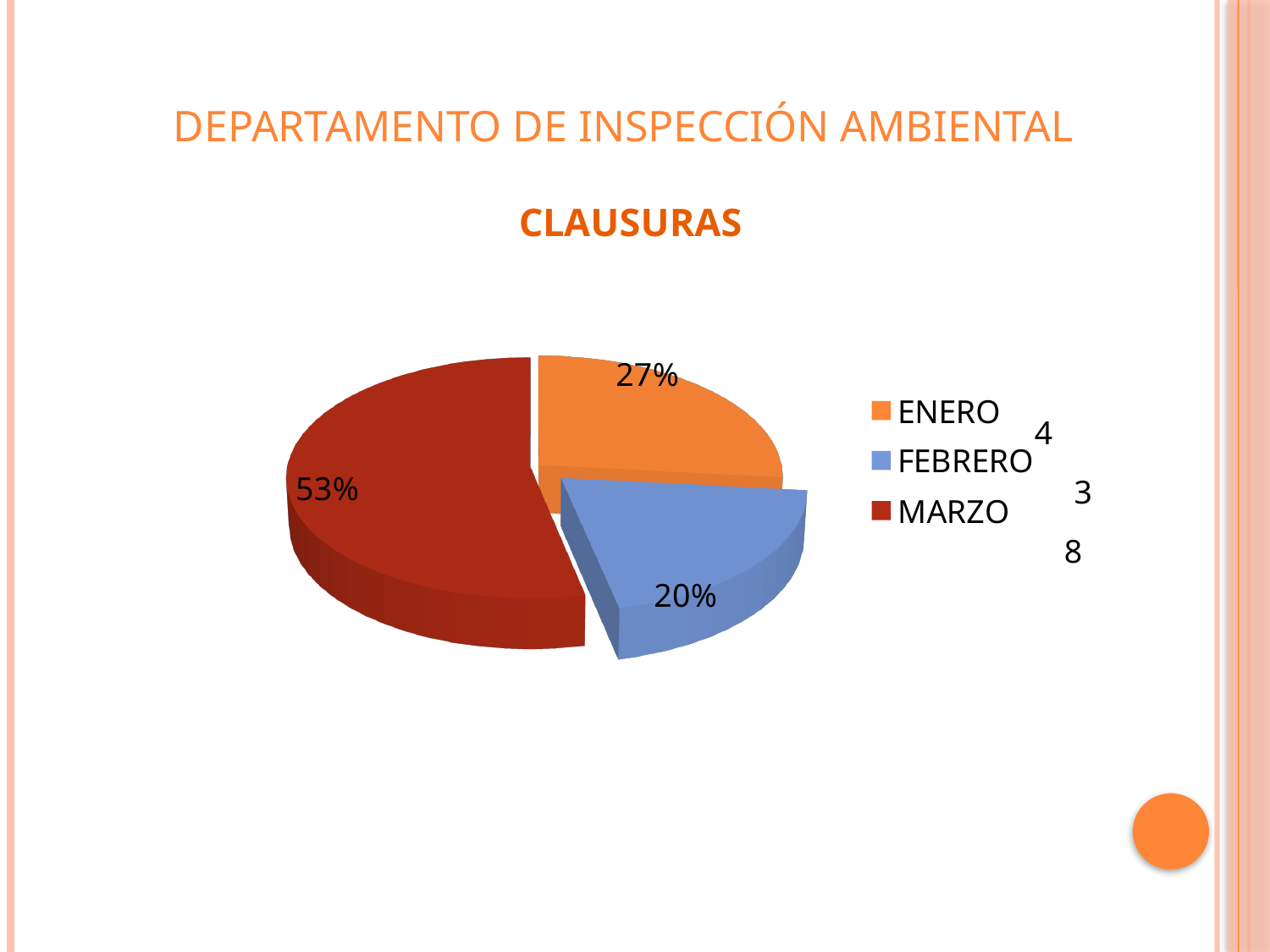
What colour is the MARZO slice? dark red How many slices does the pie chart have? 3 What percentage share does the ENERO slice have? 27% Which month has the largest slice of the pie? MARZO What kind of chart is shown on the slide? pie chart What is the difference in percentage points between the MARZO and ENERO slices? 26 How many entries does the legend list? 3 What percentage share does the FEBRERO slice have? 20% What is the title of the chart? CLAUSURAS Which month has the smallest slice of the pie? FEBRERO Which slice is larger, ENERO or FEBRERO? ENERO What percentage share does the MARZO slice have? 53%